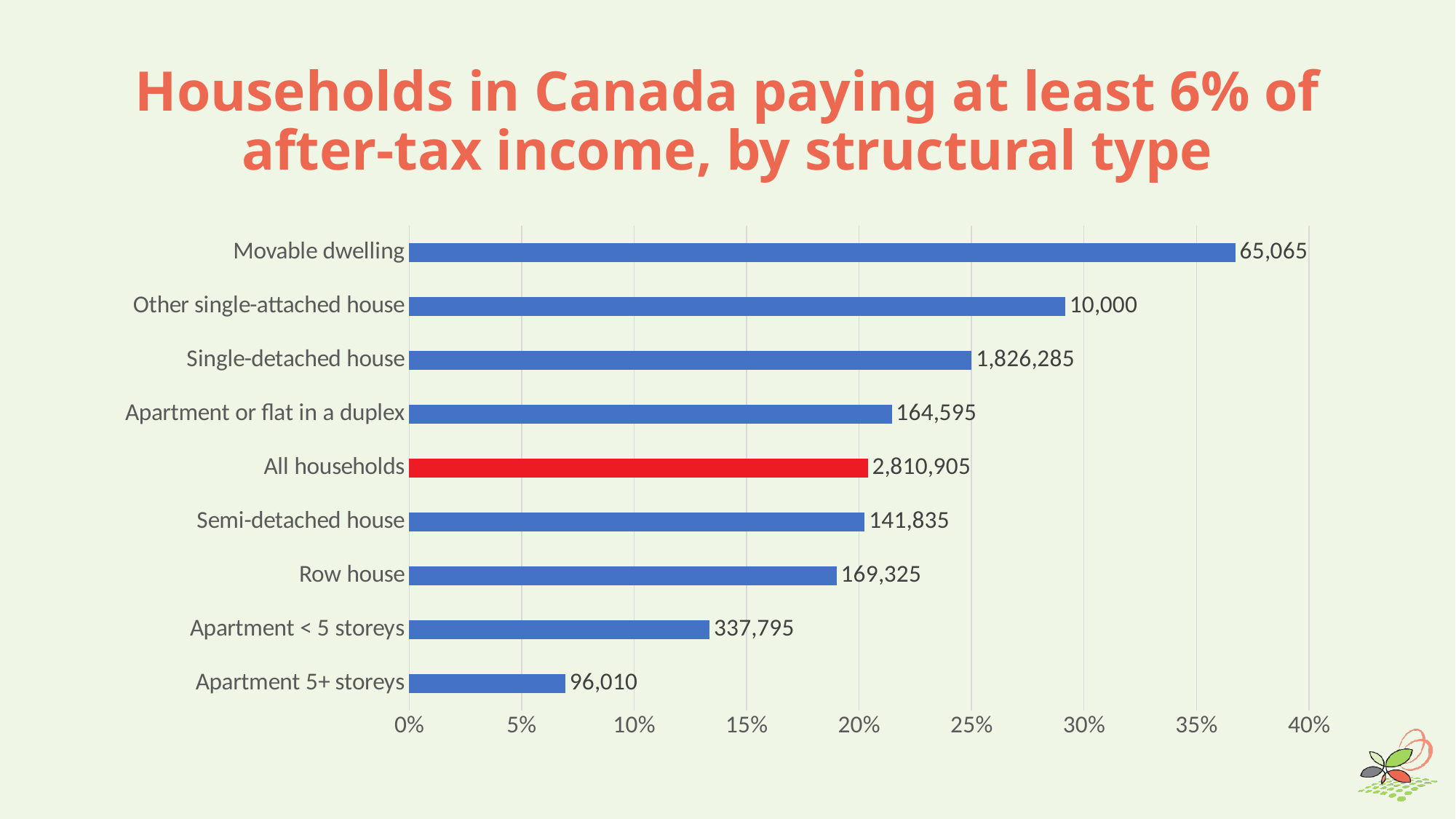
Which category's bar is coloured red instead of blue? All households How many structural type categories are plotted on the chart? 9 What number is printed next to the bar for Single-detached house? 1,826,285 Which category has the shortest bar? Apartment 5+ storeys Which category has the longest bar? Movable dwelling Is the bar for Apartment < 5 storeys greater or less than 15%? less Which bar is longer: Apartment or flat in a duplex or Row house? Apartment or flat in a duplex What number is printed next to the bar for All households? 2,810,905 What kind of chart is shown on the slide? bar chart What number is printed next to the bar for Apartment < 5 storeys? 337,795 Is the bar for Apartment 5+ storeys greater or less than 5%? greater Is the bar for Movable dwelling greater or less than 35%? greater